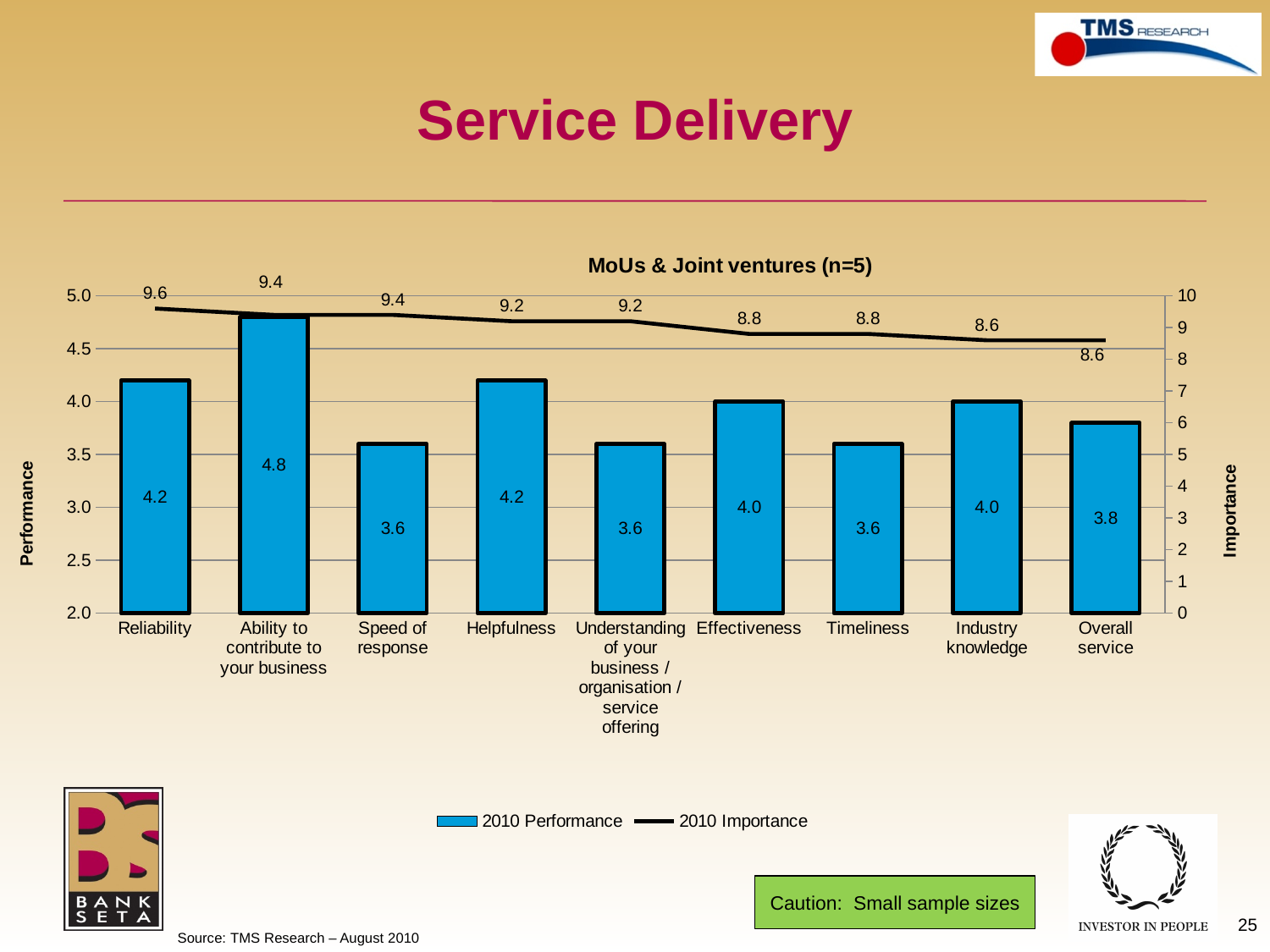
Does the 2010 Importance line generally rise or fall from Reliability to Overall service? Fall Which category has the highest 2010 Importance value? Reliability What kind of chart is used for the 2010 Performance series? Bar chart Which category has the lowest 2010 Importance value? Industry knowledge and Overall service (tied at 8.6) How many series does the legend list? 2 What is the 2010 Performance value for Reliability? 4.2 Which is larger, the 2010 Performance value for Effectiveness or for Overall service? Effectiveness What is the 2010 Importance value for Helpfulness? 9.2 What is the difference between the 2010 Performance values for Ability to contribute to your business and Speed of response? 1.2 How many categories are shown on the x axis? 9 What is the title of the chart? MoUs & Joint ventures (n=5) Which category has the highest 2010 Performance value? Ability to contribute to your business